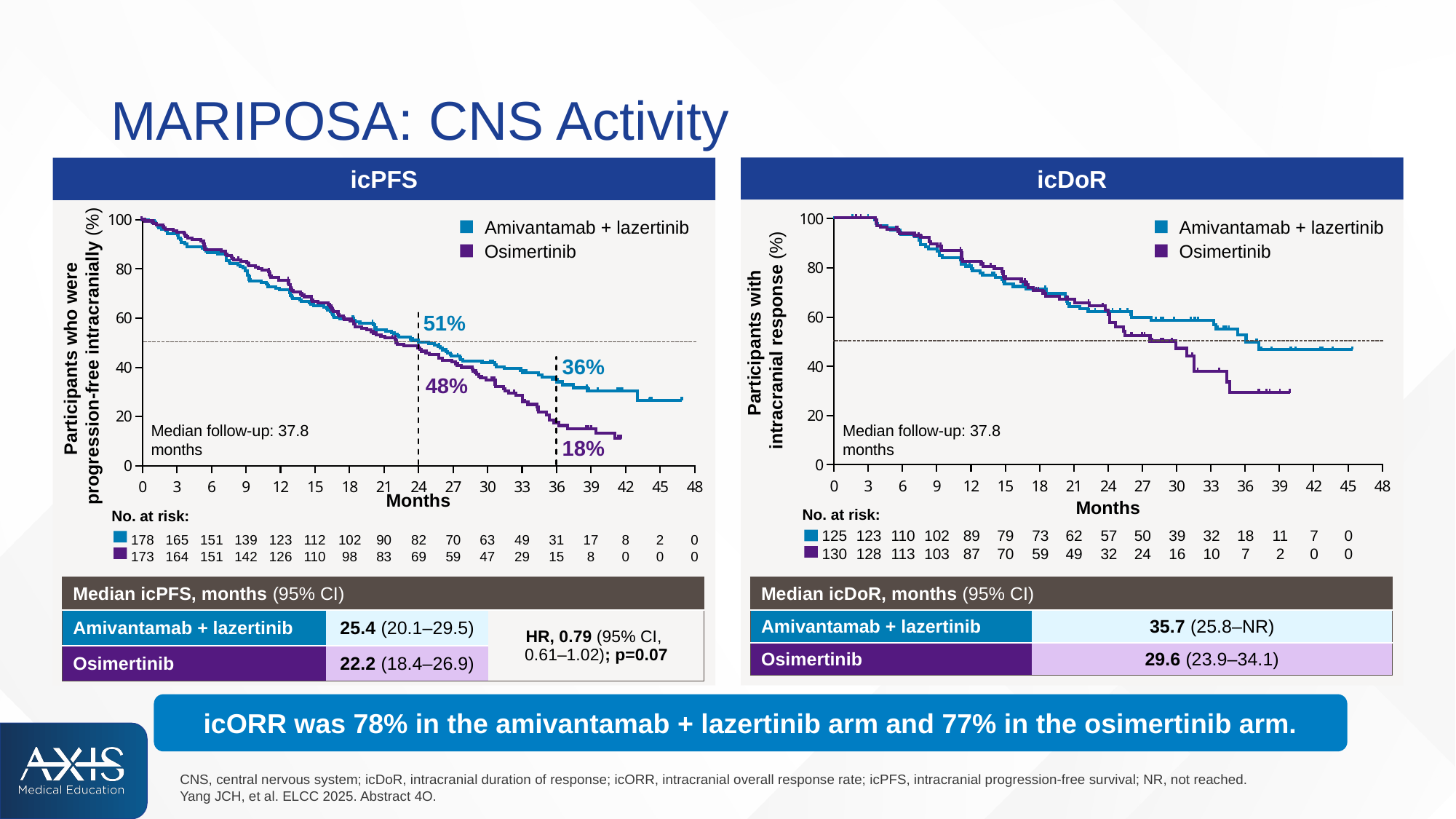
How many series does the legend of the icDoR chart list? 2 What median follow-up is stated on the icPFS chart? 37.8 months In the icPFS chart, how many participants in the osimertinib arm were at risk at 0 months? 173 In the icPFS chart, what percentage of participants in the osimertinib arm were progression-free intracranially at 36 months? 18% What kind of chart is the icPFS chart? Line chart (Kaplan-Meier curve) In the icPFS chart, what percentage of participants in the amivantamab + lazertinib arm were progression-free intracranially at 24 months? 51% In the icDoR chart, do the curves rise or fall as months increase? Fall In the icDoR chart, is the osimertinib curve at 36 months greater or less than 40%? less In the icPFS chart, which arm has the higher labelled rate at 24 months? Amivantamab + lazertinib What is the median icDoR in months for the osimertinib arm? 29.6 In the icPFS chart, what is the difference between the two arms' labelled rates at 36 months? 18% In the icDoR chart, how many participants in the amivantamab + lazertinib arm were at risk at 12 months? 89